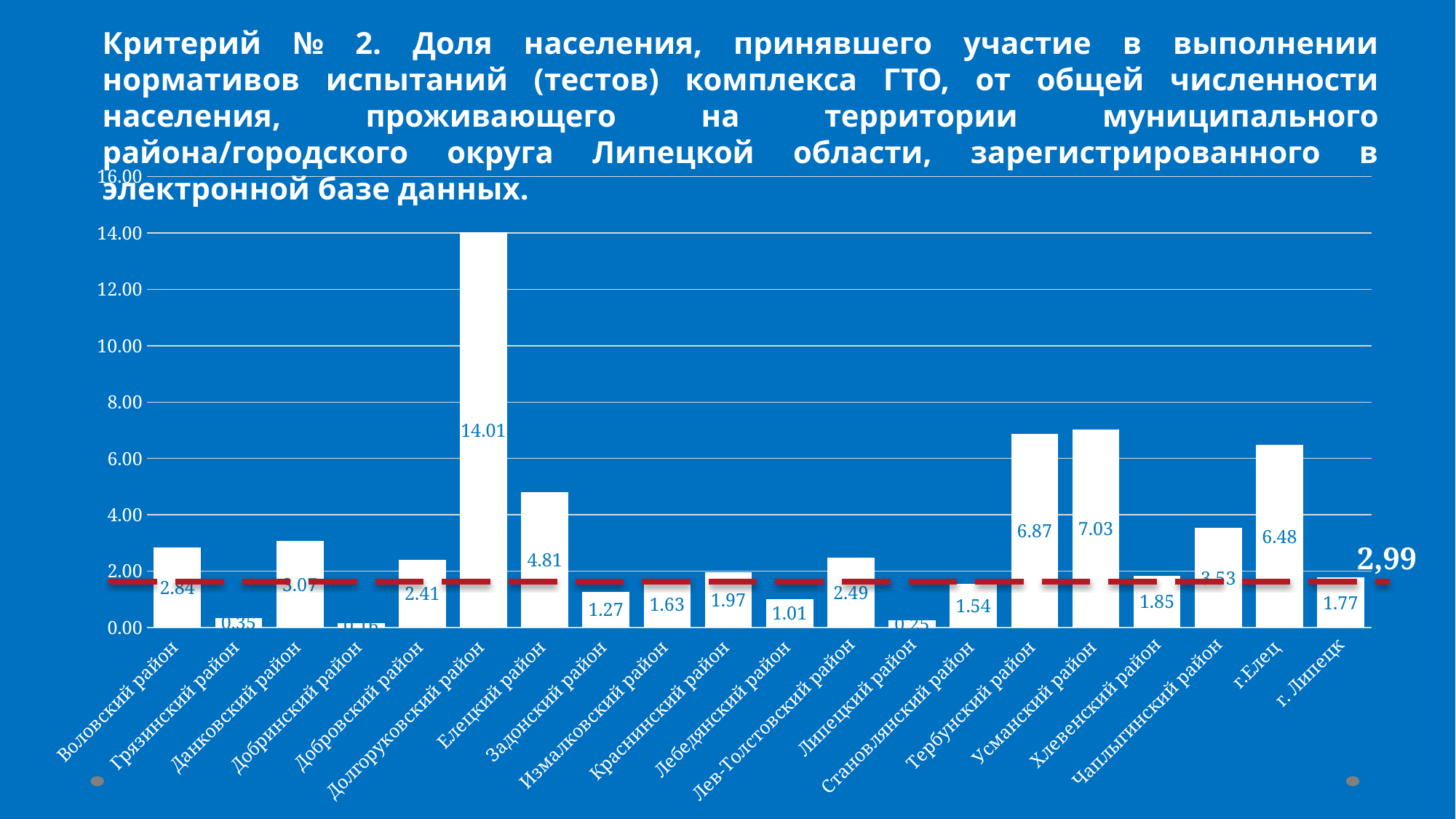
What is the value for г. Липецк? 1.77 What kind of chart is shown on the slide? bar chart What is the difference between the values for Усманский район and Тербунский район? 0.16 How many categories are shown on the x axis? 20 What is the difference between the values for Воловский район and Добровский район? 0.43 Is the value for Елецкий район greater or less than 4.00? greater Which is larger, the value for г.Елец or the value for Тербунский район? Тербунский район What is the value for Чаплыгинский район? 3.53 What value is labelled on the red dashed horizontal line? 2,99 What is the value for Усманский район? 7.03 Which category has the highest value? Долгоруковский район What is the value for Долгоруковский район? 14.01